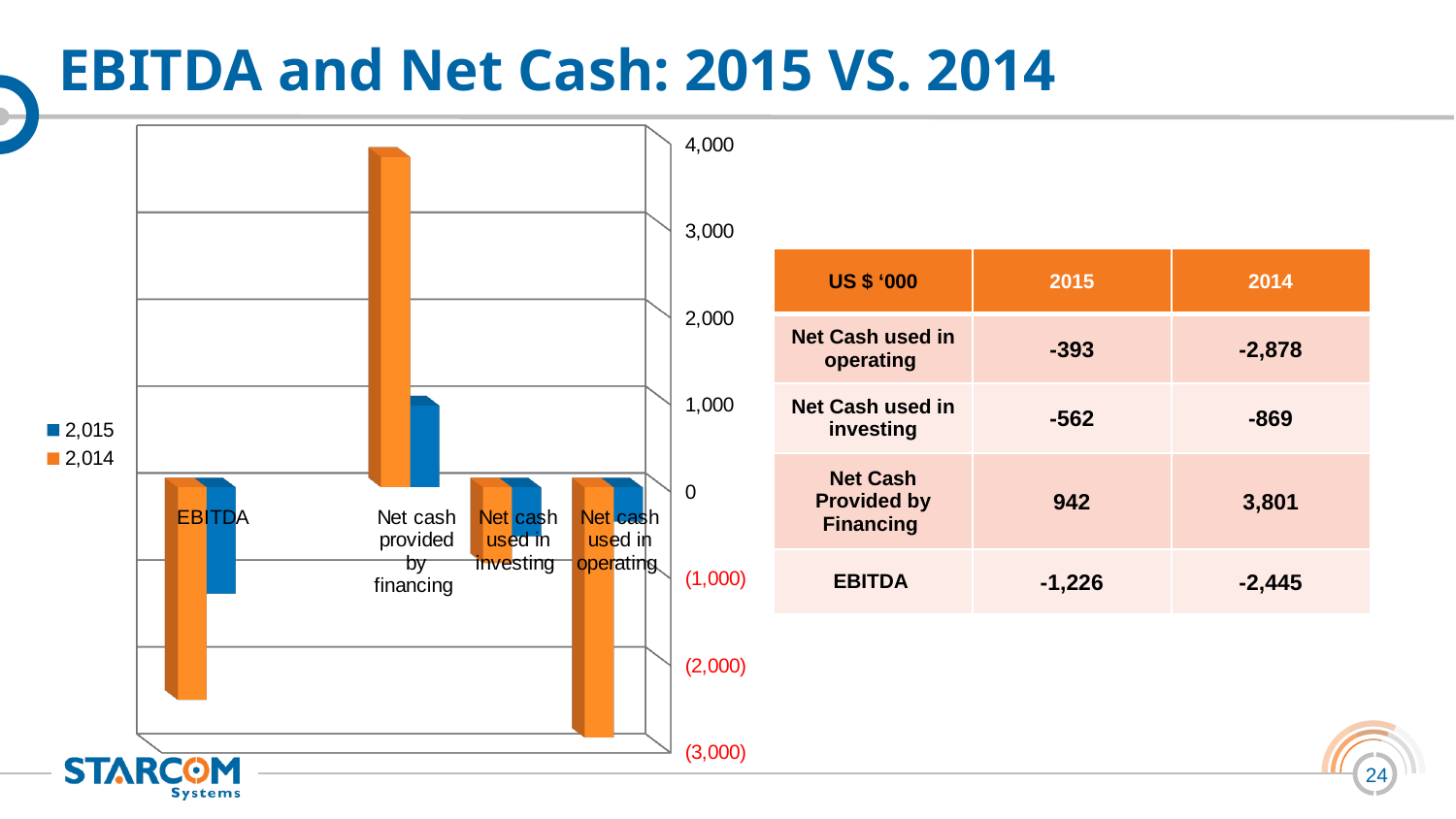
Which category has the highest bar on the chart? Net cash provided by financing Is the 2014 value for Net cash provided by financing greater or less than 3,000? greater What are the two entries in the chart legend? 2,015 and 2,014 How many series does the chart legend list? 2 What is the 2015 value for EBITDA? -1,226 What is the difference between the 2014 and 2015 values for Net Cash Provided by Financing? 2,859 For Net cash used in operating, which year's bar is higher, 2015 or 2014? 2015 Which category has the lowest bar on the chart? Net cash used in operating What colour are the bars for the 2014 series? orange What type of chart is shown on the slide? bar chart Is the 2014 value for Net cash used in operating greater or less than (2,000)? less How many categories are plotted on the chart? 4